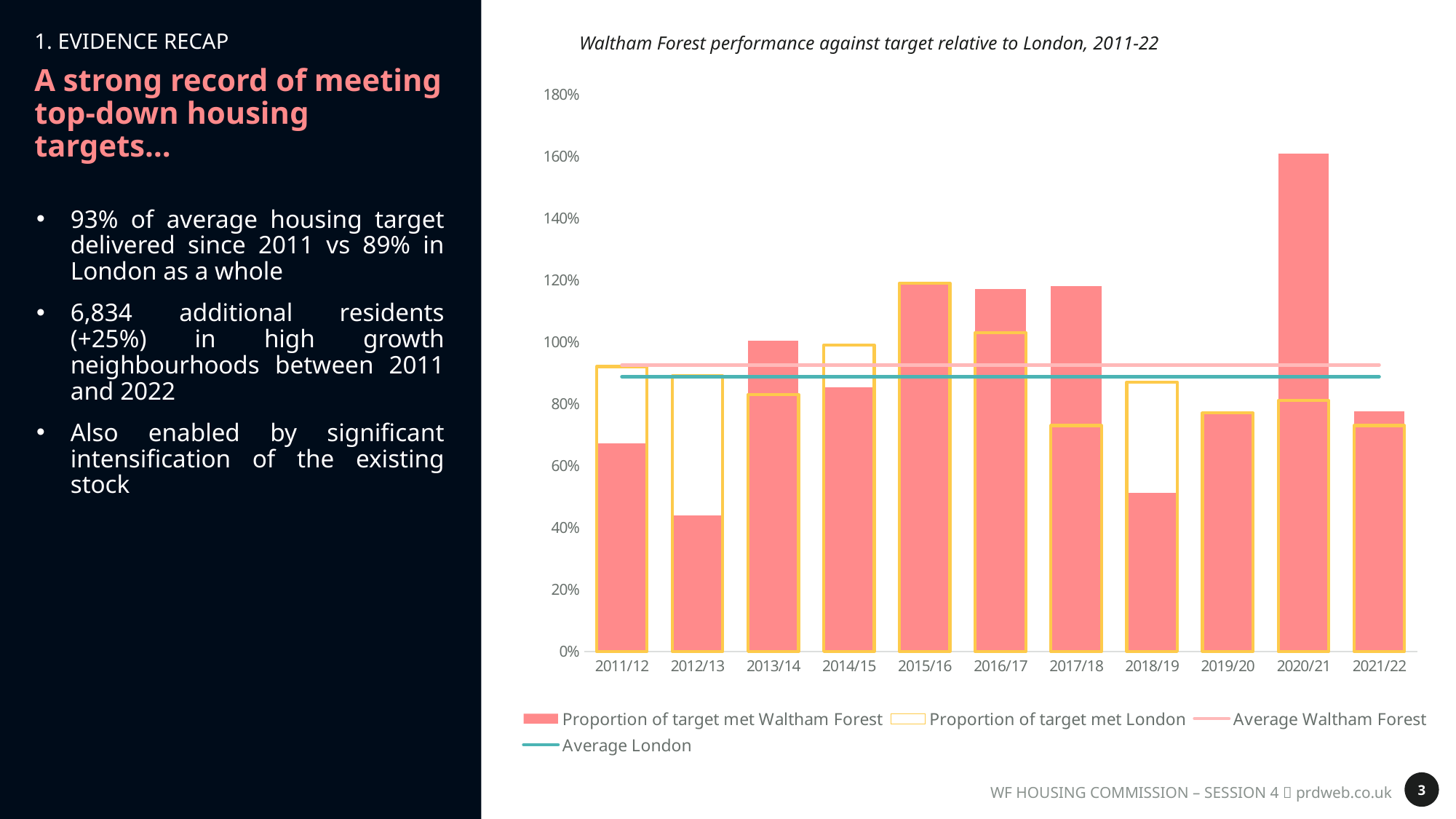
Is the proportion of target met by Waltham Forest in 2012/13 greater or less than 60%? less How many years are shown along the x axis of the chart? 11 Is the proportion of target met by Waltham Forest in 2020/21 greater or less than 140%? greater What is the title of the chart? Waltham Forest performance against target relative to London, 2011-22 In 2018/19, which is larger: the proportion of target met by Waltham Forest or by London? London Which average line sits higher on the chart: Average Waltham Forest or Average London? Average Waltham Forest In which year is the proportion of target met by London highest? 2015/16 How many series does the chart legend list? 4 Is the proportion of target met by London in 2017/18 greater or less than 80%? less In which year is the proportion of target met by Waltham Forest lowest? 2012/13 What kind of chart is shown on the slide? Combination bar and line chart In which year is the proportion of target met by Waltham Forest highest? 2020/21